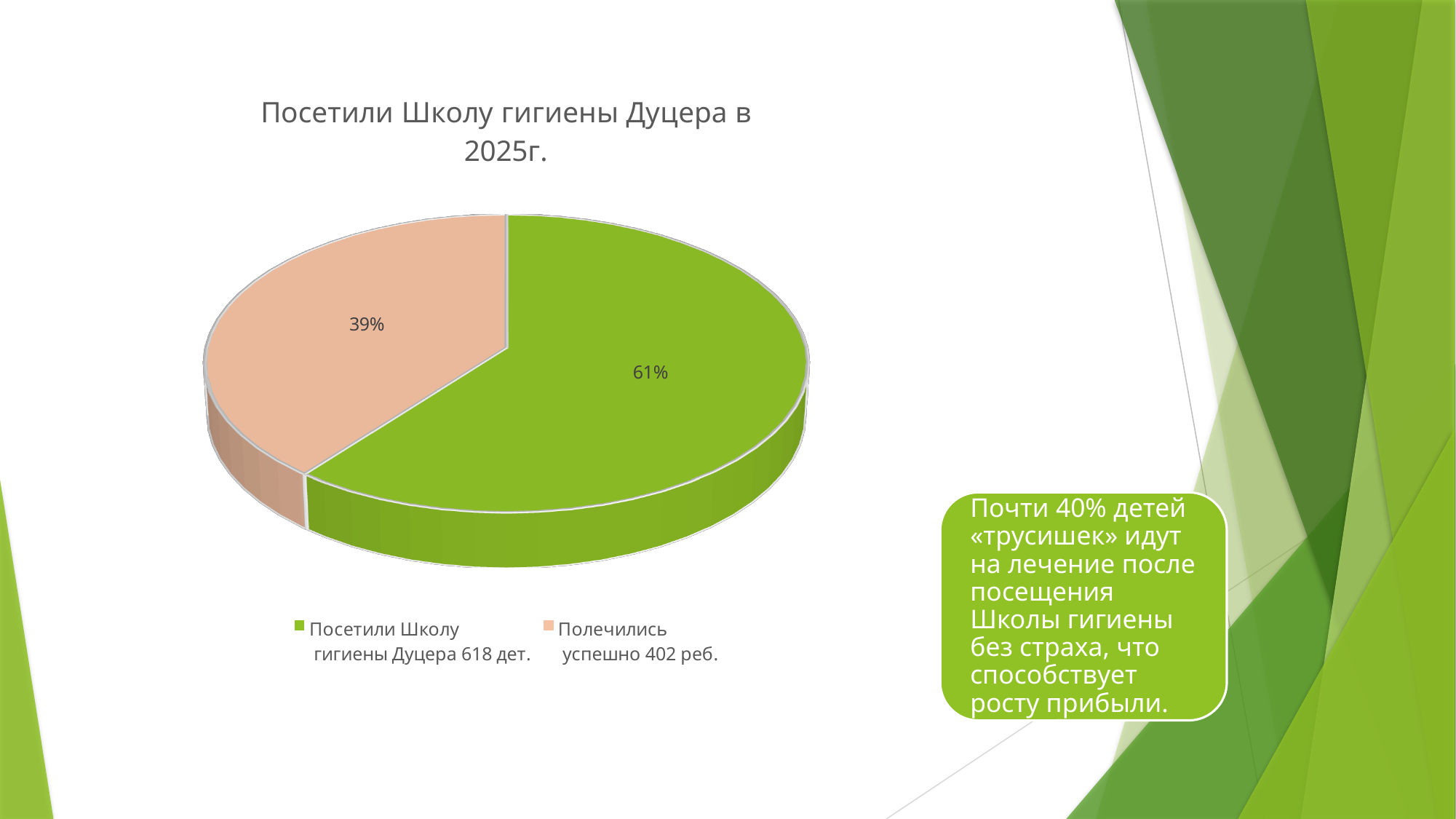
What colour is the slice labelled 39%? peach (light orange) Which slice of the pie is the smallest? Полечились успешно 402 реб. Which is larger: the slice for 'Посетили Школу гигиены Дуцера 618 дет.' or the slice for 'Полечились успешно 402 реб.'? Посетили Школу гигиены Дуцера 618 дет. How many entries does the legend list? 2 How many slices does the pie chart have? 2 What is the difference in percentage points between the 61% slice and the 39% slice? 22 What is the title of the chart? Посетили Школу гигиены Дуцера в 2025г. What percentage is shown for the slice 'Полечились успешно 402 реб.'? 39% Which slice of the pie is the largest? Посетили Школу гигиены Дуцера 618 дет. What kind of chart is shown on the slide? pie chart What share of the pie does the green slice represent? 61% What percentage is shown for the slice 'Посетили Школу гигиены Дуцера 618 дет.'? 61%